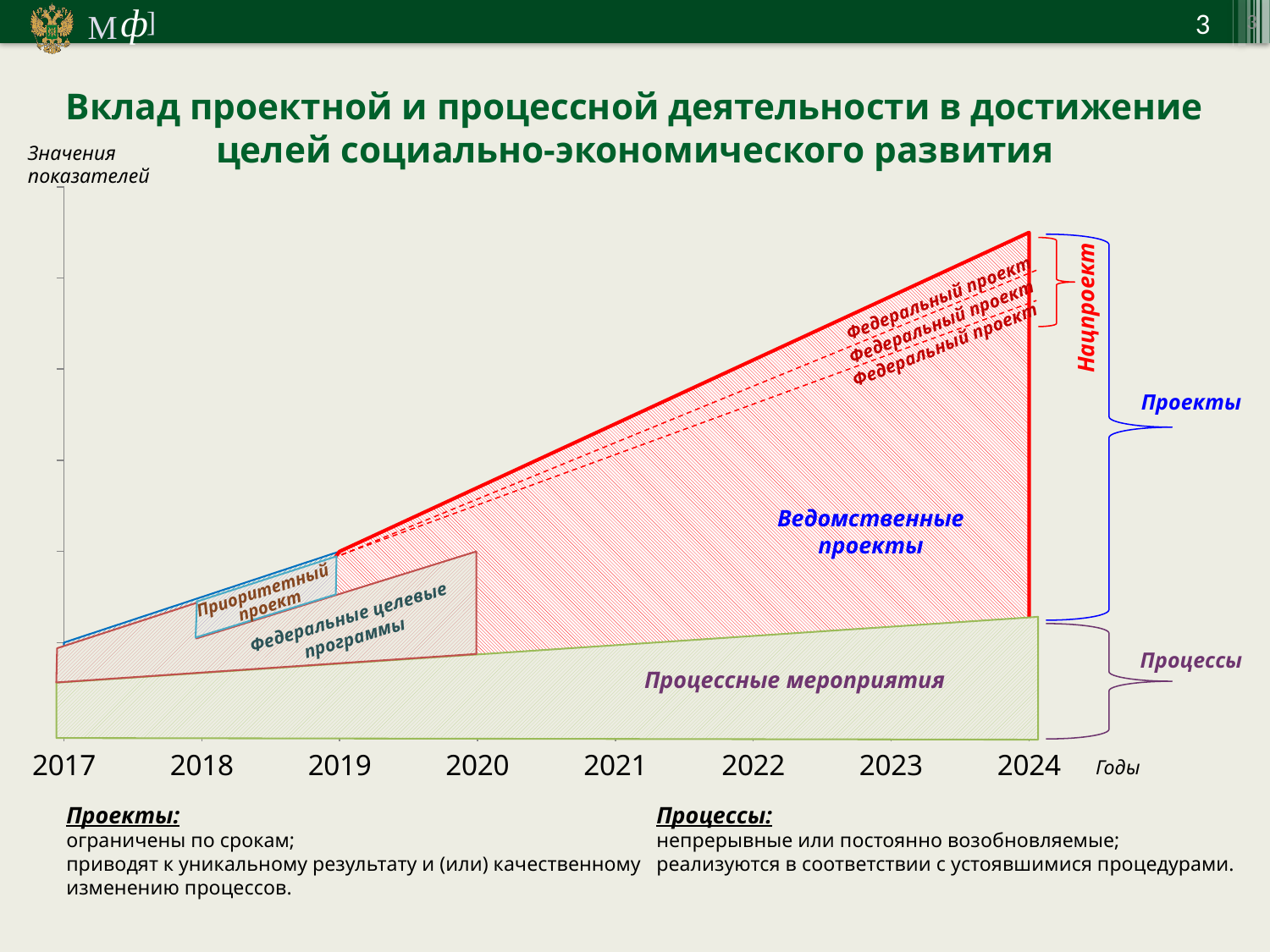
Does the upper boundary of the green area labelled 'Процессные мероприятия' rise or fall from 2017 to 2024? rises How many year labels are shown along the x axis of the chart? 8 Does the upper boundary of the red hatched area labelled 'Ведомственные проекты' rise or fall from 2017 to 2024? rises How many dashed lines labelled 'Федеральный проект' are drawn inside the red area of the chart? 2 What is the first year shown on the x axis of the chart? 2017 What is the label of the y axis of the chart? Значения показателей What is the last year shown on the x axis of the chart? 2024 In which year does the area labelled 'Федеральные целевые программы' end on the x axis? 2020 In which year does the area labelled 'Приоритетный проект' end on the x axis? 2019 What is the label of the x axis of the chart? Годы